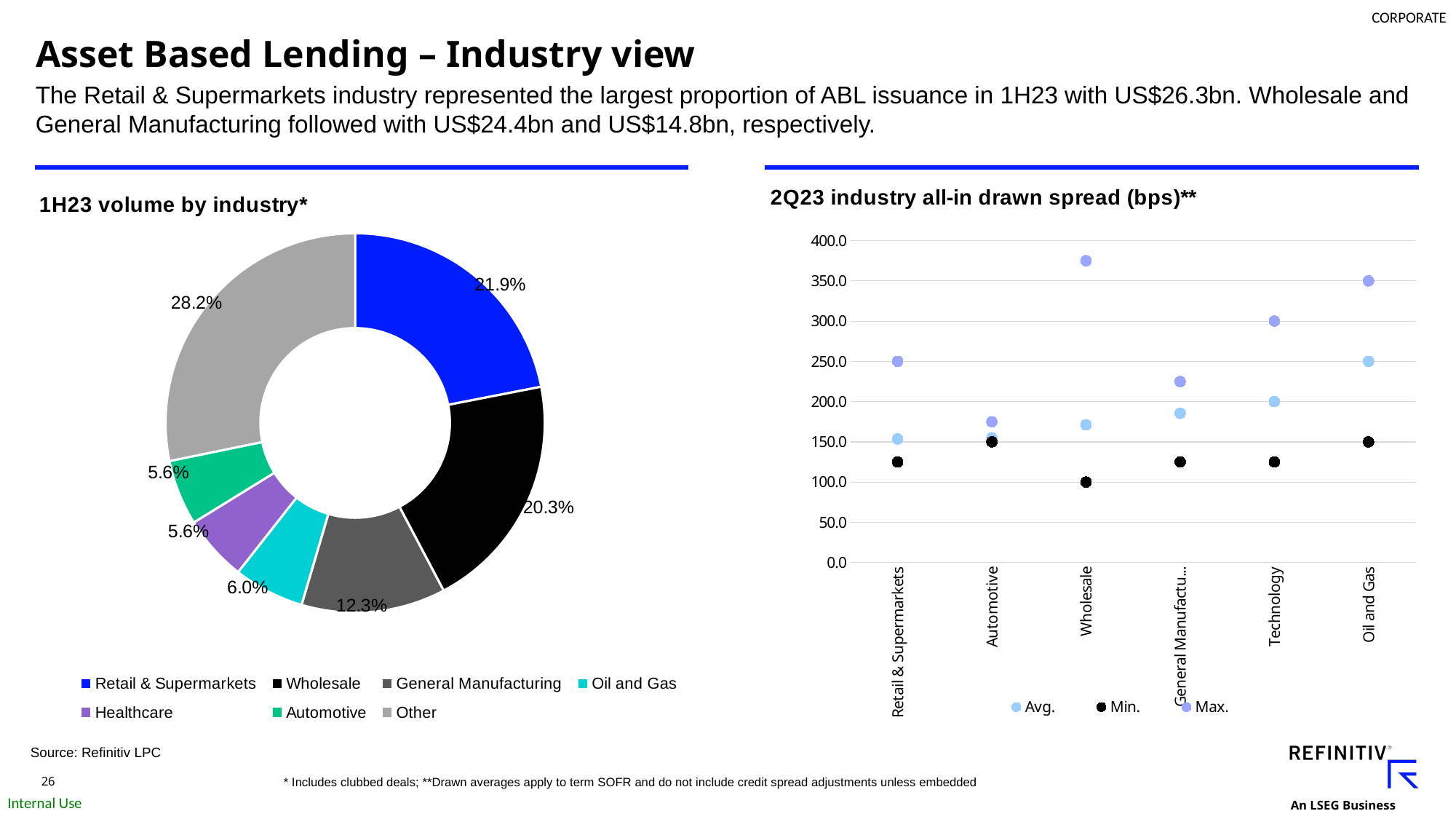
In the '2Q23 industry all-in drawn spread (bps)**' chart, which industry has the highest Max. value? Wholesale In the '1H23 volume by industry*' chart, what share does Wholesale have? 20.3% In the '2Q23 industry all-in drawn spread (bps)**' chart, is the Min. value for Wholesale greater or less than 150? less How many categories does the '1H23 volume by industry*' chart show? 7 In the '2Q23 industry all-in drawn spread (bps)**' chart, is the Max. value for Wholesale greater or less than 350? greater How many industries are shown on the x axis of the '2Q23 industry all-in drawn spread (bps)**' chart? 6 In the '1H23 volume by industry*' chart, what share does Retail & Supermarkets have? 21.9% What kind of chart is the '1H23 volume by industry*' chart? doughnut chart How many series does the legend of the '2Q23 industry all-in drawn spread (bps)**' chart list? 3 In the '1H23 volume by industry*' chart, which is larger: General Manufacturing or Oil and Gas? General Manufacturing In the '1H23 volume by industry*' chart, which category has the largest slice? Other In the '1H23 volume by industry*' chart, what is the difference between the Retail & Supermarkets share and the Wholesale share? 1.6%